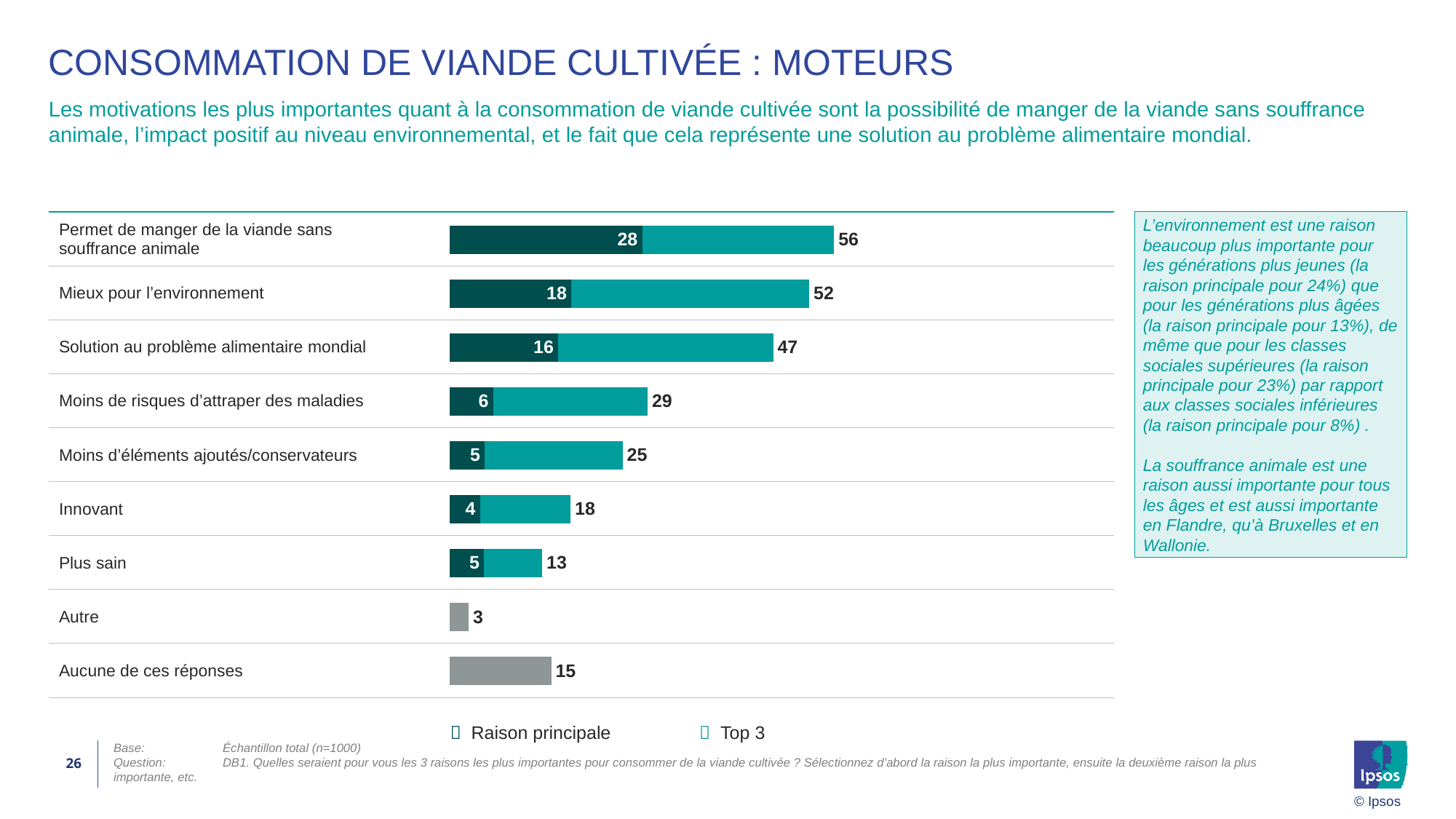
Which category has the highest "Top 3" value? Permet de manger de la viande sans souffrance animale How many categories are listed in the chart? 9 Which category has the lowest "Raison principale" value among the teal bars? Innovant What type of chart is shown on the slide? Bar chart What value is shown for "Aucune de ces réponses"? 15 What is the "Raison principale" value for "Mieux pour l'environnement"? 18 What is the "Top 3" value for "Permet de manger de la viande sans souffrance animale"? 56 How many series does the legend list? 2 What is the "Top 3" value for "Solution au problème alimentaire mondial"? 47 Which has a larger "Top 3" value: "Moins de risques d'attraper des maladies" or "Moins d'éléments ajoutés/conservateurs"? Moins de risques d'attraper des maladies What is the "Raison principale" value for "Innovant"? 4 What is the difference between the "Top 3" values for "Mieux pour l'environnement" and "Solution au problème alimentaire mondial"? 5